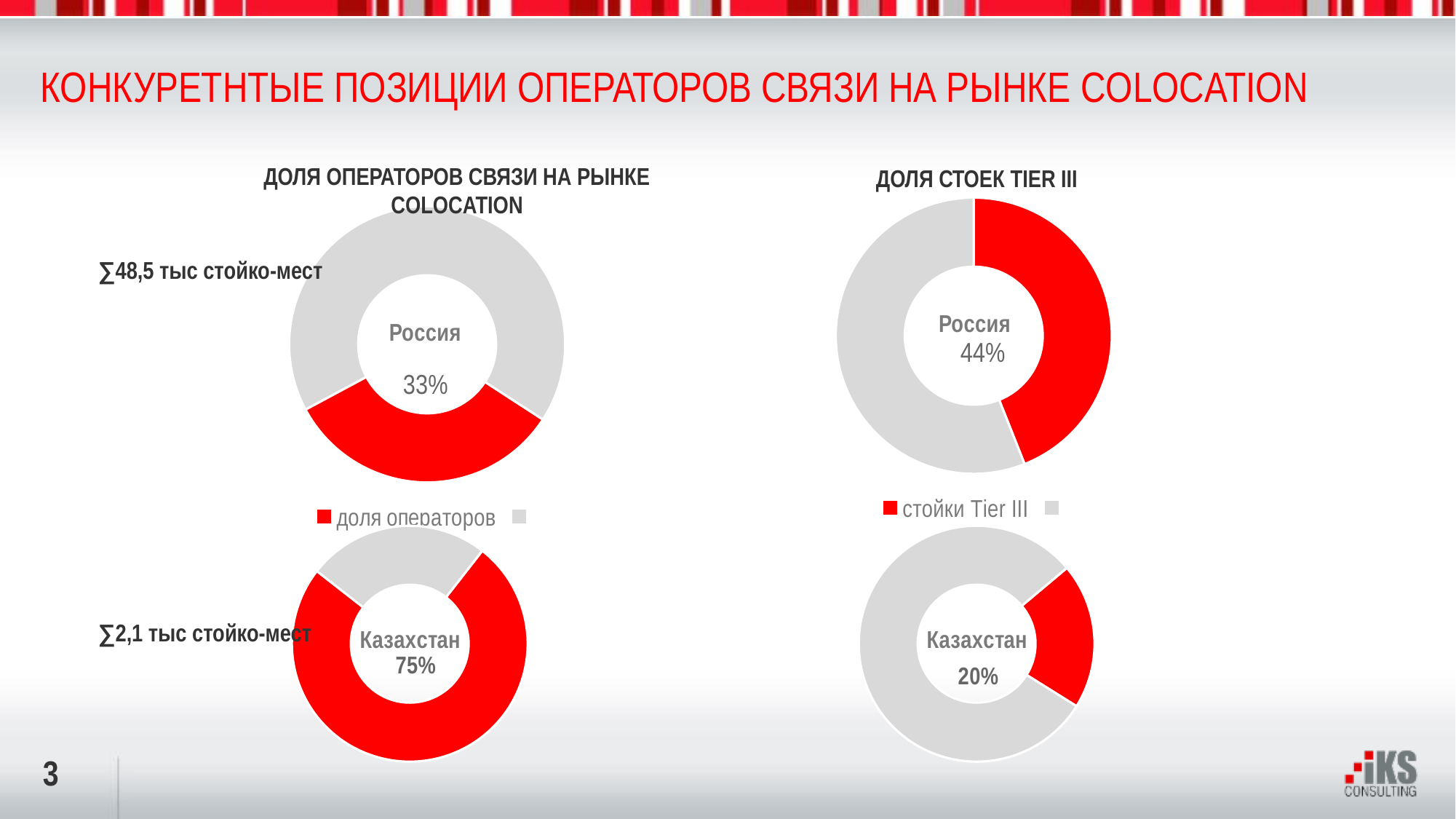
What type of chart is used for the 'ДОЛЯ СТОЕК TIER III' visuals on the right side of the slide? Donut (pie) chart How many donut charts are shown on the slide in total? 4 In the top-left donut chart under 'ДОЛЯ ОПЕРАТОРОВ СВЯЗИ НА РЫНКЕ COLOCATION', what share is shown for Россия? 33% In the top-right donut chart under 'ДОЛЯ СТОЕК TIER III', what share is shown for Россия? 44% Comparing the two charts under 'ДОЛЯ СТОЕК TIER III', which country has the larger share of Tier III racks: Россия or Казахстан? Россия What is the total number of rack places (стойко-мест) stated next to the Россия chart on the left? ∑48,5 тыс стойко-мест What legend label is shown in red under the 'ДОЛЯ СТОЕК TIER III' chart for Россия? стойки Tier III Comparing the two charts under 'ДОЛЯ ОПЕРАТОРОВ СВЯЗИ НА РЫНКЕ COLOCATION', which country has the larger share of operators: Россия or Казахстан? Казахстан What is the difference between the Россия share (44%) and the Казахстан share (20%) in the 'ДОЛЯ СТОЕК TIER III' charts? 24% In the bottom-left donut chart under 'ДОЛЯ ОПЕРАТОРОВ СВЯЗИ НА РЫНКЕ COLOCATION', what share is shown for Казахстан? 75% In the bottom-right donut chart under 'ДОЛЯ СТОЕК TIER III', what share is shown for Казахстан? 20% What is the difference between the Казахстан share (75%) and the Россия share (33%) in the 'ДОЛЯ ОПЕРАТОРОВ СВЯЗИ НА РЫНКЕ COLOCATION' charts? 42%